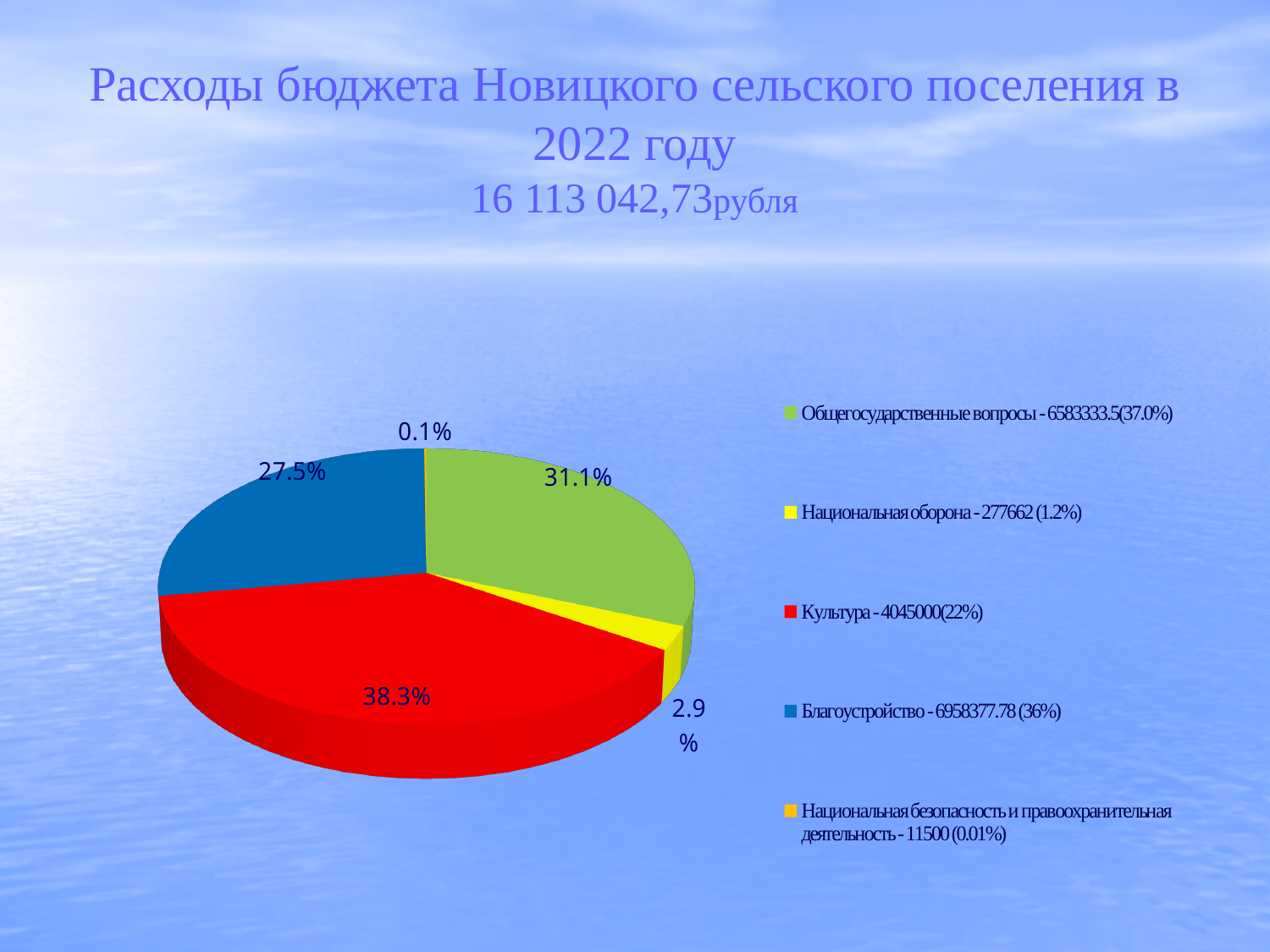
Which category has the largest slice of the pie? Культура What percentage is shown on the red slice (Культура)? 38.3% What percentage is shown on the green slice (Общегосударственные вопросы)? 31.1% Which category has the smallest slice of the pie? Национальная безопасность и правоохранительная деятельность What kind of chart is shown on the slide? Pie chart How many entries does the legend list? 5 Which slice is larger, the green one (Общегосударственные вопросы) or the blue one (Благоустройство)? Общегосударственные вопросы How many slices does the pie chart have? 5 What total budget amount in rubles is stated in the slide title? 16 113 042,73 By how many percentage points does the red slice (38.3%) exceed the blue slice (27.5%)? 10.8 What percentage is shown on the blue slice (Благоустройство)? 27.5% What percentage is shown on the yellow slice (Национальная оборона)? 2.9%